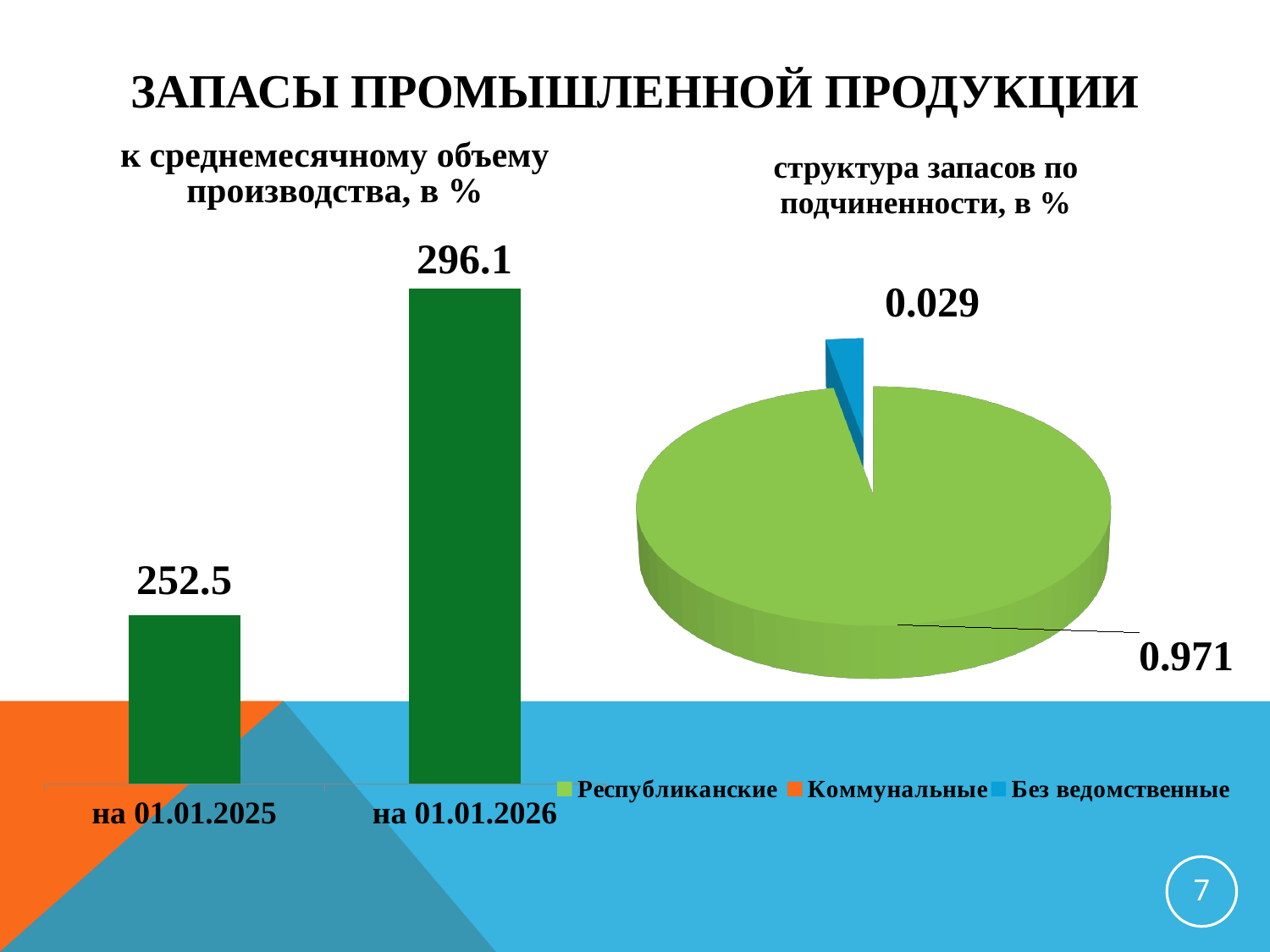
On the left chart (к среднемесячному объему производства, в %), what is the value for на 01.01.2026? 296.1 On the right chart (структура запасов по подчиненности, в %), what is the value of the blue slice (Без ведомственные)? 0.029 What kind of chart is the left chart (к среднемесячному объему производства, в %)? bar chart On the right chart (структура запасов по подчиненности, в %), what is the value of the green slice (Республиканские)? 0.971 On the left chart (к среднемесячному объему производства, в %), does the value rise or fall from на 01.01.2025 to на 01.01.2026? rise What kind of chart is the right chart (структура запасов по подчиненности, в %)? pie chart How many entries does the legend of the right chart (структура запасов по подчиненности, в %) list? 3 On the left chart (к среднемесячному объему производства, в %), what is the value for на 01.01.2025? 252.5 On the left chart (к среднемесячному объему производства, в %), which date has the higher value? на 01.01.2026 On the left chart (к среднемесячному объему производства, в %), which date has the lower value? на 01.01.2025 On the left chart (к среднемесячному объему производства, в %), how many bars are plotted? 2 On the left chart (к среднемесячному объему производства, в %), what is the difference between the values for на 01.01.2026 and на 01.01.2025? 43.6